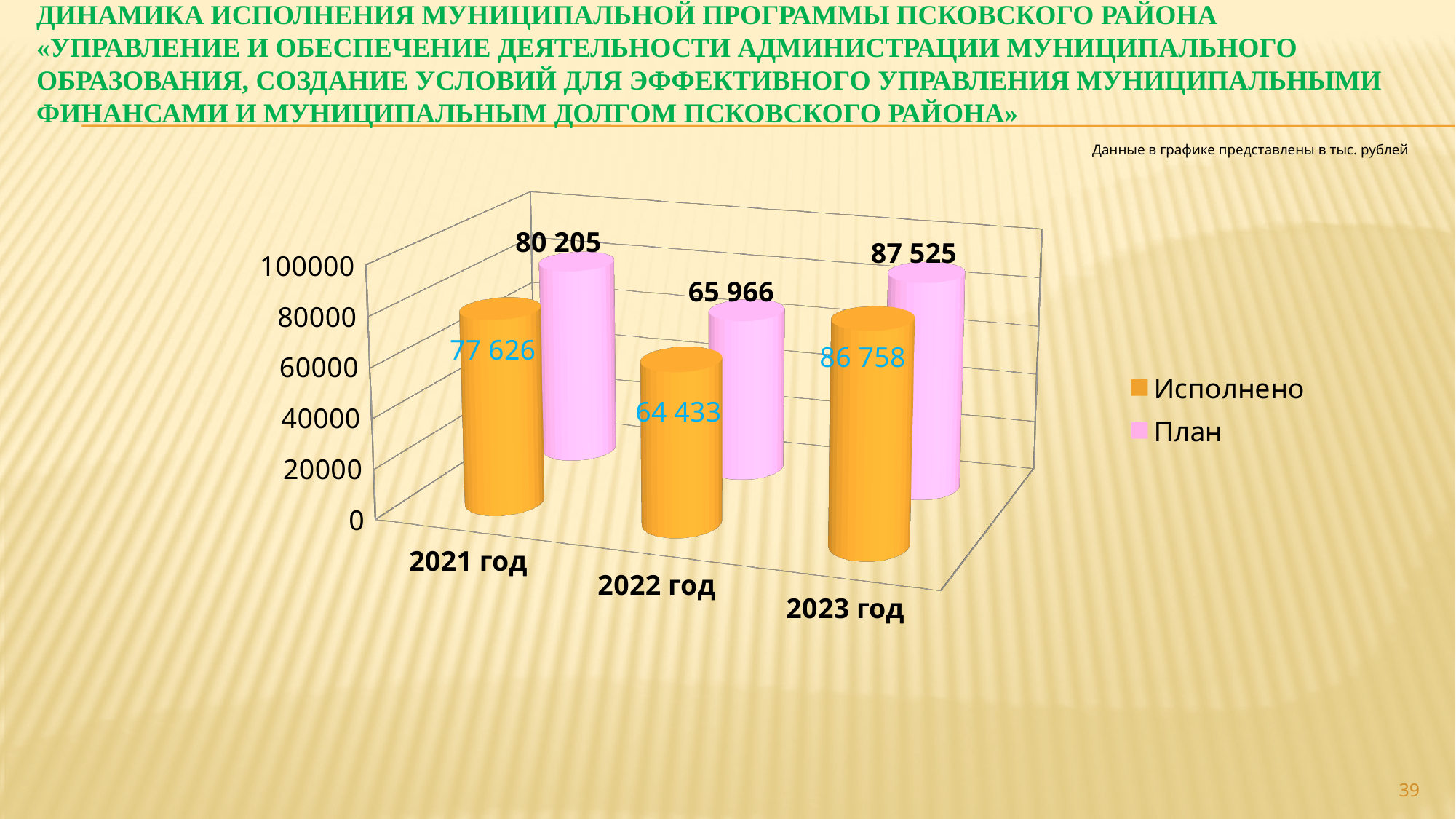
What is the value of План for 2023 год? 87 525 What kind of chart is shown on the slide? Bar chart What is the value of Исполнено for 2021 год? 77 626 In what units are the data in the chart presented, according to the note on the slide? тыс. рублей What is the difference between План and Исполнено for 2023 год? 767 What is the value of План for 2022 год? 65 966 How many years are shown on the x axis of the chart? 3 In which year is the Исполнено value the highest? 2023 год In which year is the План value the lowest? 2022 год How many series does the legend list? 2 For 2022 год, which is larger: План or Исполнено? План What is the difference between План and Исполнено for 2021 год? 2 579